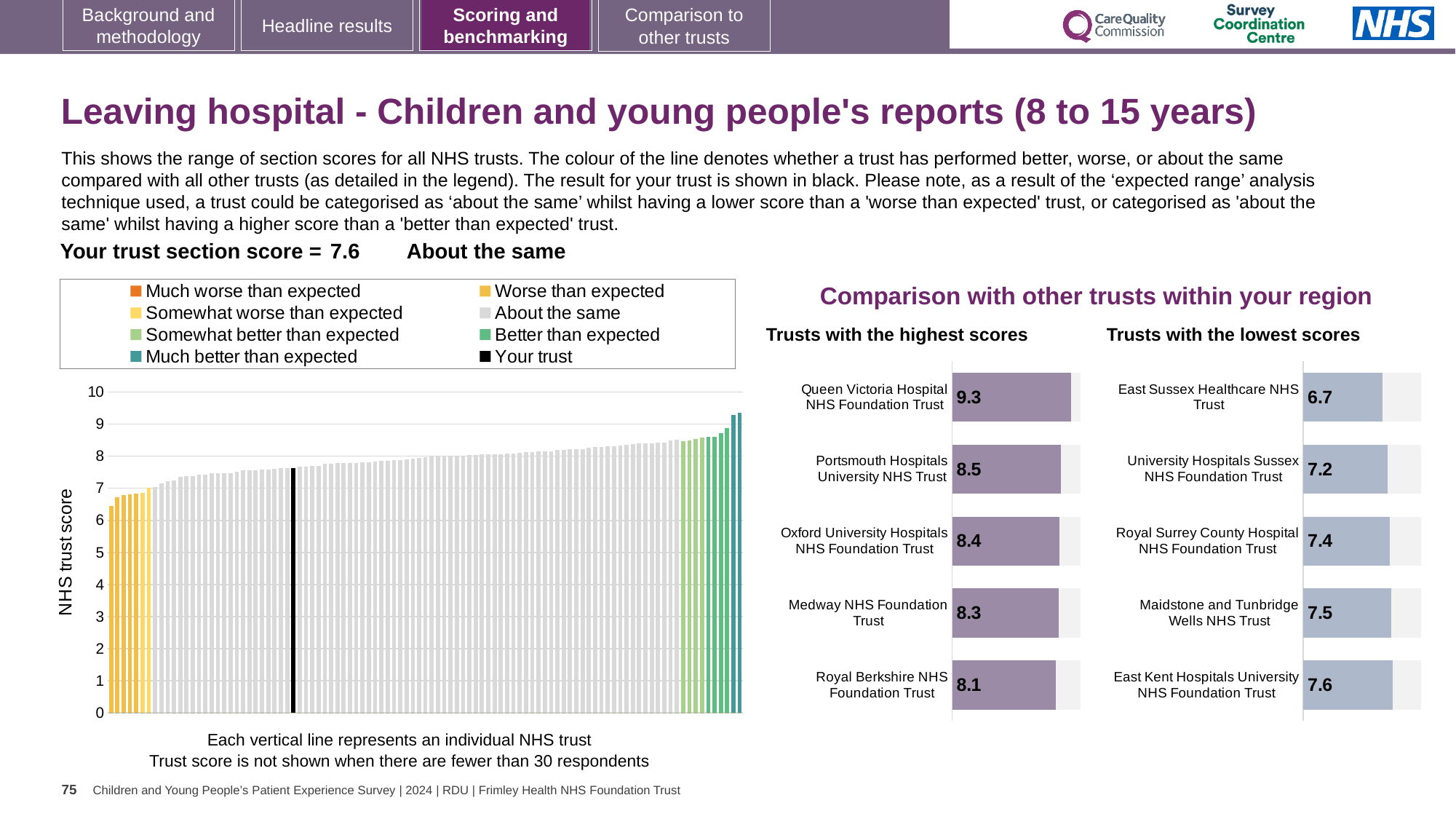
In the 'Trusts with the highest scores' chart, which has the larger score: Portsmouth Hospitals University NHS Trust or Medway NHS Foundation Trust? Portsmouth Hospitals University NHS Trust In the 'Trusts with the highest scores' chart, what is the score for Queen Victoria Hospital NHS Foundation Trust? 9.3 In the main 'NHS trust score' chart, do the trust scores rise or fall from left to right? Rise In the 'Trusts with the lowest scores' chart, which trust has the highest score shown? East Kent Hospitals University NHS Foundation Trust How many trusts are listed in the 'Trusts with the lowest scores' chart? 5 In the 'Trusts with the highest scores' chart, what is the difference between the scores of Queen Victoria Hospital NHS Foundation Trust and Royal Berkshire NHS Foundation Trust? 1.2 In the 'Trusts with the highest scores' chart, which trust has the lowest score shown? Royal Berkshire NHS Foundation Trust In the 'Trusts with the lowest scores' chart, what is the score for East Sussex Healthcare NHS Trust? 6.7 In the 'Trusts with the lowest scores' chart, what is the difference between the scores of East Kent Hospitals University NHS Foundation Trust and East Sussex Healthcare NHS Trust? 0.9 How many entries does the legend of the main 'NHS trust score' chart list? 8 In the main 'NHS trust score' chart, what is the section score for your trust (the black bar)? 7.6 What kind of chart is the main 'NHS trust score' chart? Bar chart